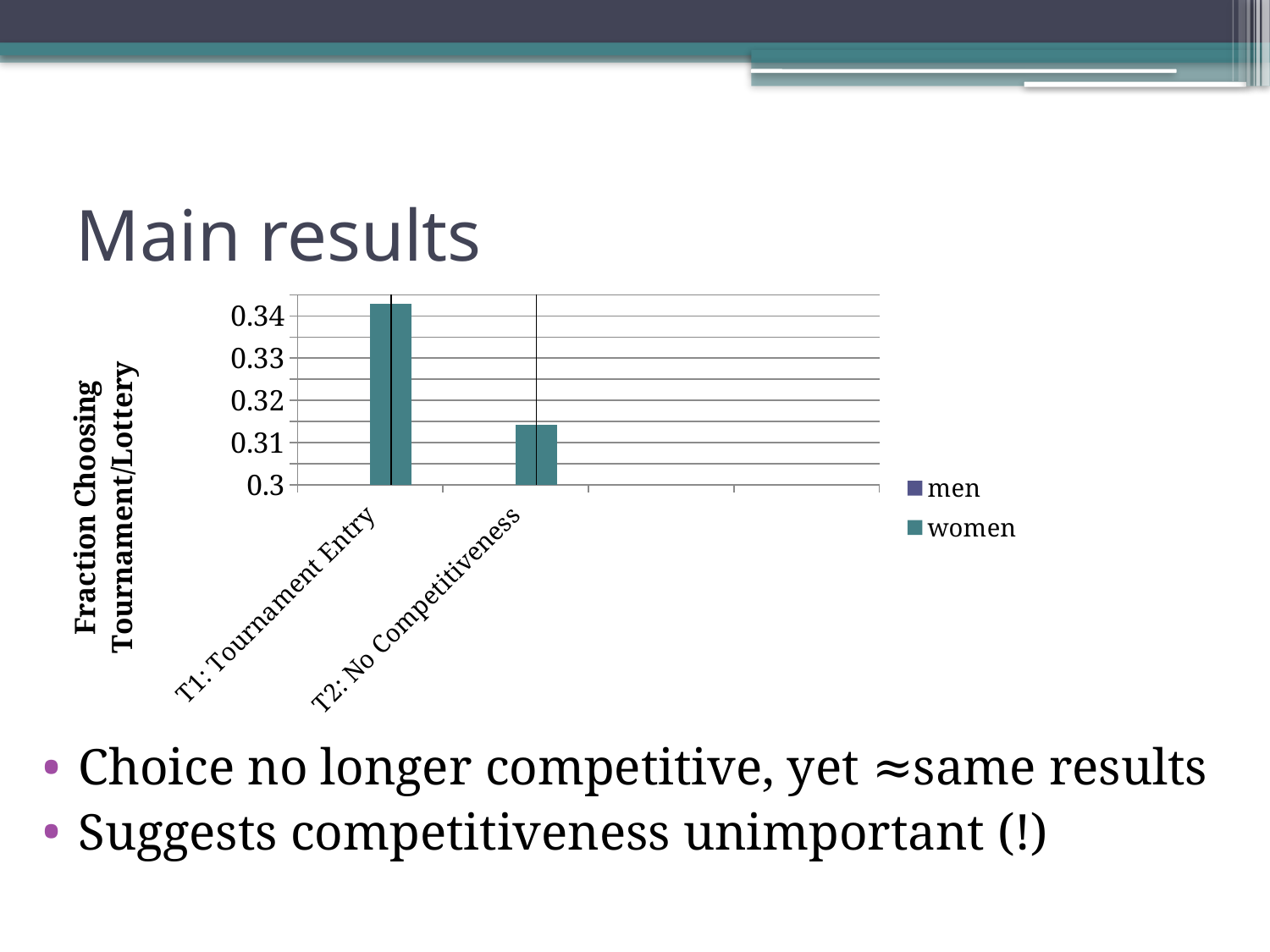
What is the label of the vertical axis? Fraction Choosing Tournament/Lottery Which category has the higher value for women, T1: Tournament Entry or T2: No Competitiveness? T1: Tournament Entry What are the two series named in the legend? men and women Is the value for women in T2: No Competitiveness greater or less than 0.31? greater Is the value for women in T1: Tournament Entry greater or less than 0.33? greater What kind of chart is shown on the slide? bar chart What is the lowest value shown on the vertical axis? 0.3 Is the value for women in T2: No Competitiveness greater or less than 0.32? less How many series does the legend list? 2 Which category has the lowest value for women? T2: No Competitiveness Do the values for women rise or fall from T1: Tournament Entry to T2: No Competitiveness? fall How many labelled categories are on the x axis? 2